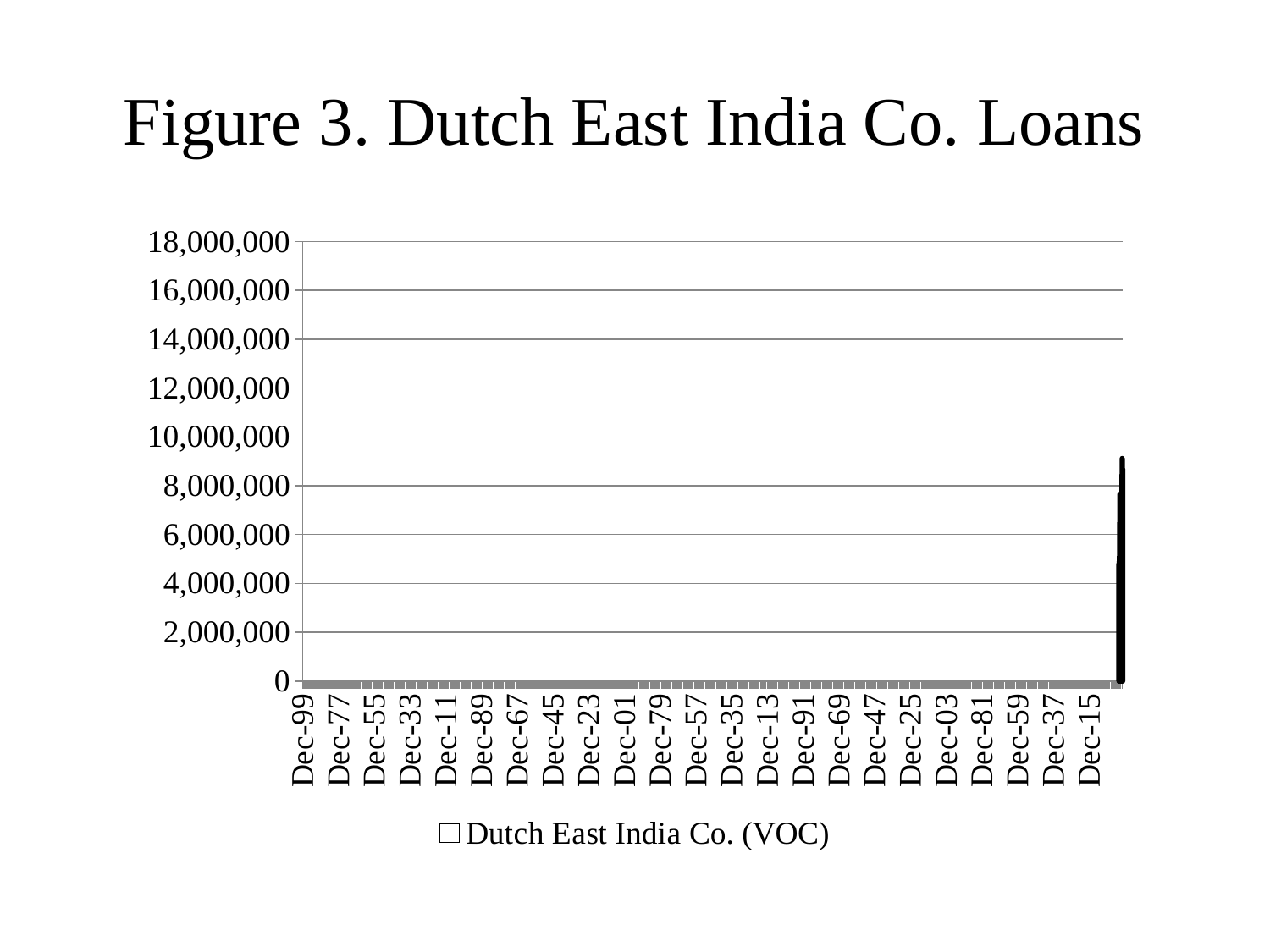
Where along the x axis does the tallest bar appear: at the left end, in the middle, or at the right end? at the right end What kind of chart is shown on the slide? area chart What is the name of the series shown in the legend? Dutch East India Co. (VOC) How many series does the legend list? 1 Is the value of the tallest bar greater or less than 8,000,000? greater What is the title of the chart? Figure 3. Dutch East India Co. Loans Is the value of the tallest bar greater or less than 10,000,000? less